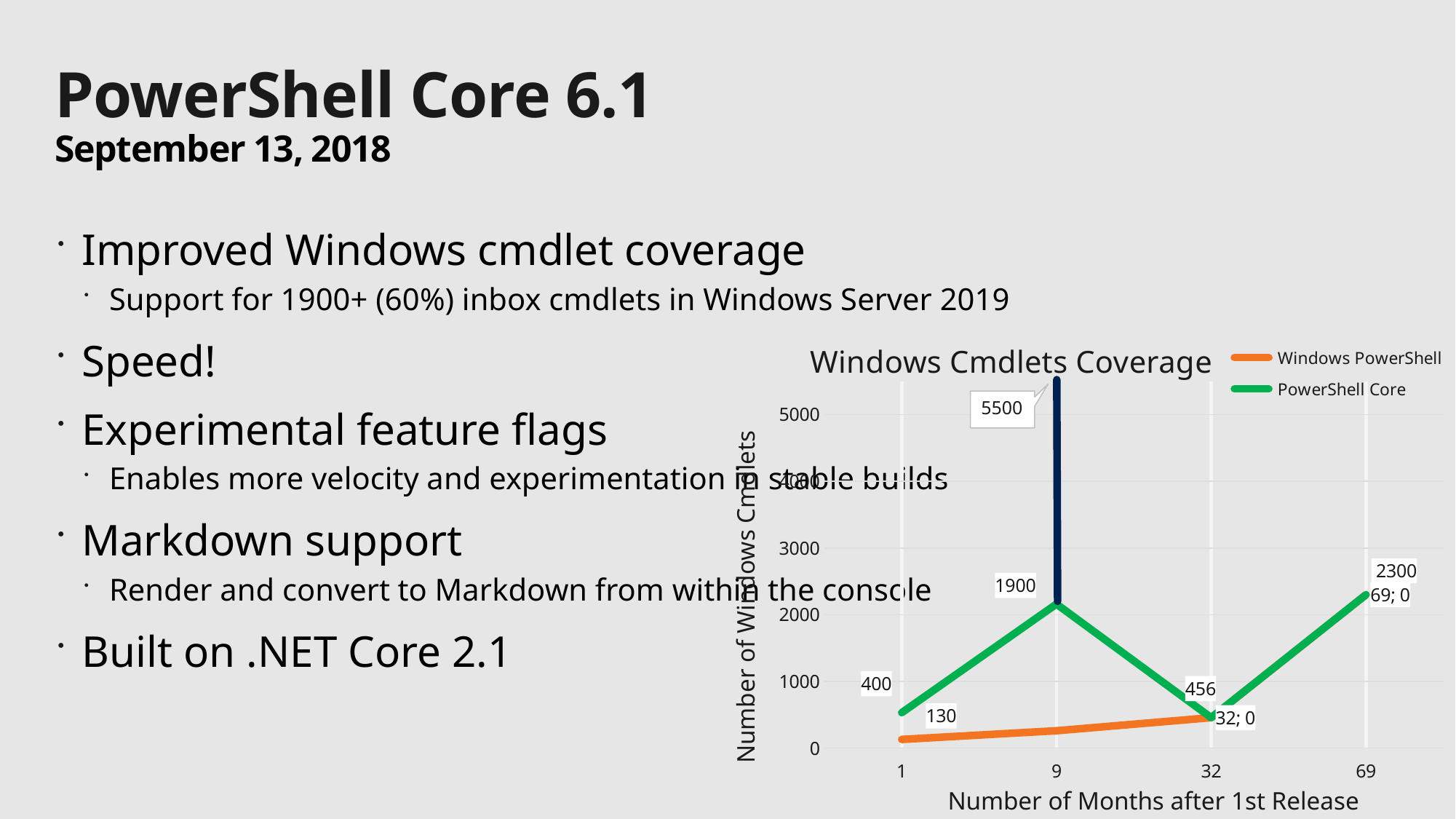
What is the value for Windows PowerShell at 1 month after 1st release? 130 What is the value for Windows PowerShell at 32 months after 1st release? 456 What is the value for PowerShell Core at 1 month after 1st release? 400 What kind of chart is shown on the slide? line chart At how many months after 1st release does PowerShell Core reach its highest labelled value? 69 At 1 month after 1st release, which series has the larger value, Windows PowerShell or PowerShell Core? PowerShell Core What is the value for PowerShell Core at 69 months after 1st release? 2300 What is the value for PowerShell Core at 9 months after 1st release? 1900 What is the difference between the PowerShell Core values at 9 months and 1 month? 1500 What is the title of the chart? Windows Cmdlets Coverage How many series does the chart legend list? 2 How many points are marked on the x axis of the chart? 4